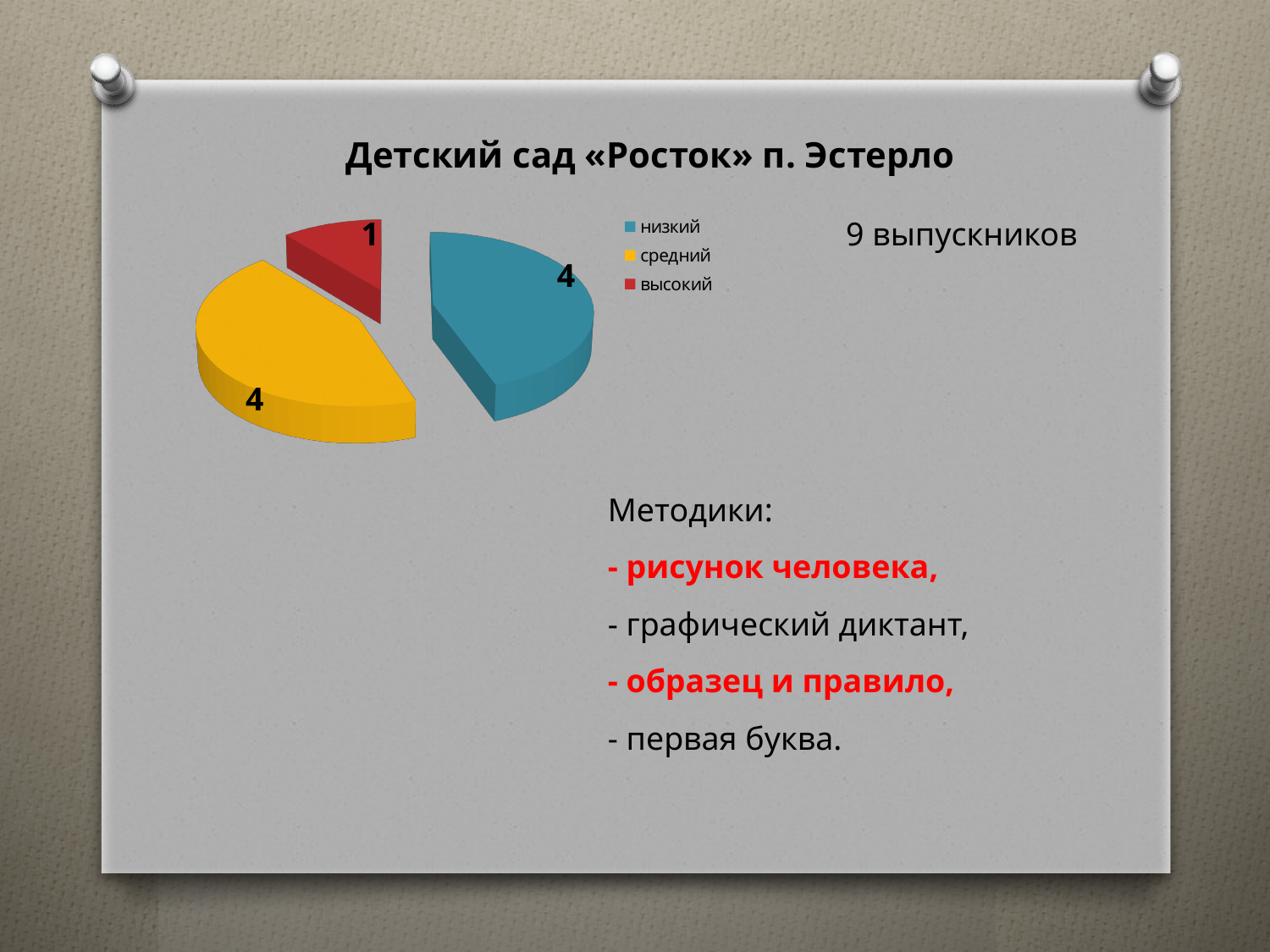
What kind of chart is shown on the slide? pie chart What is the difference between the values for «низкий» and «высокий»? 3 Which is larger: the value for «средний» or the value for «высокий»? средний How many entries does the chart legend list? 3 What value is shown for the «высокий» slice of the pie chart? 1 How many slices does the pie chart have? 3 What colour is the «высокий» slice in the pie chart? red What value is shown for the «низкий» slice of the pie chart? 4 What is the total of all the values shown in the pie chart? 9 What is the title shown above the chart? Детский сад «Росток» п. Эстерло Which category has the smallest slice in the pie chart? высокий What value is shown for the «средний» slice of the pie chart? 4